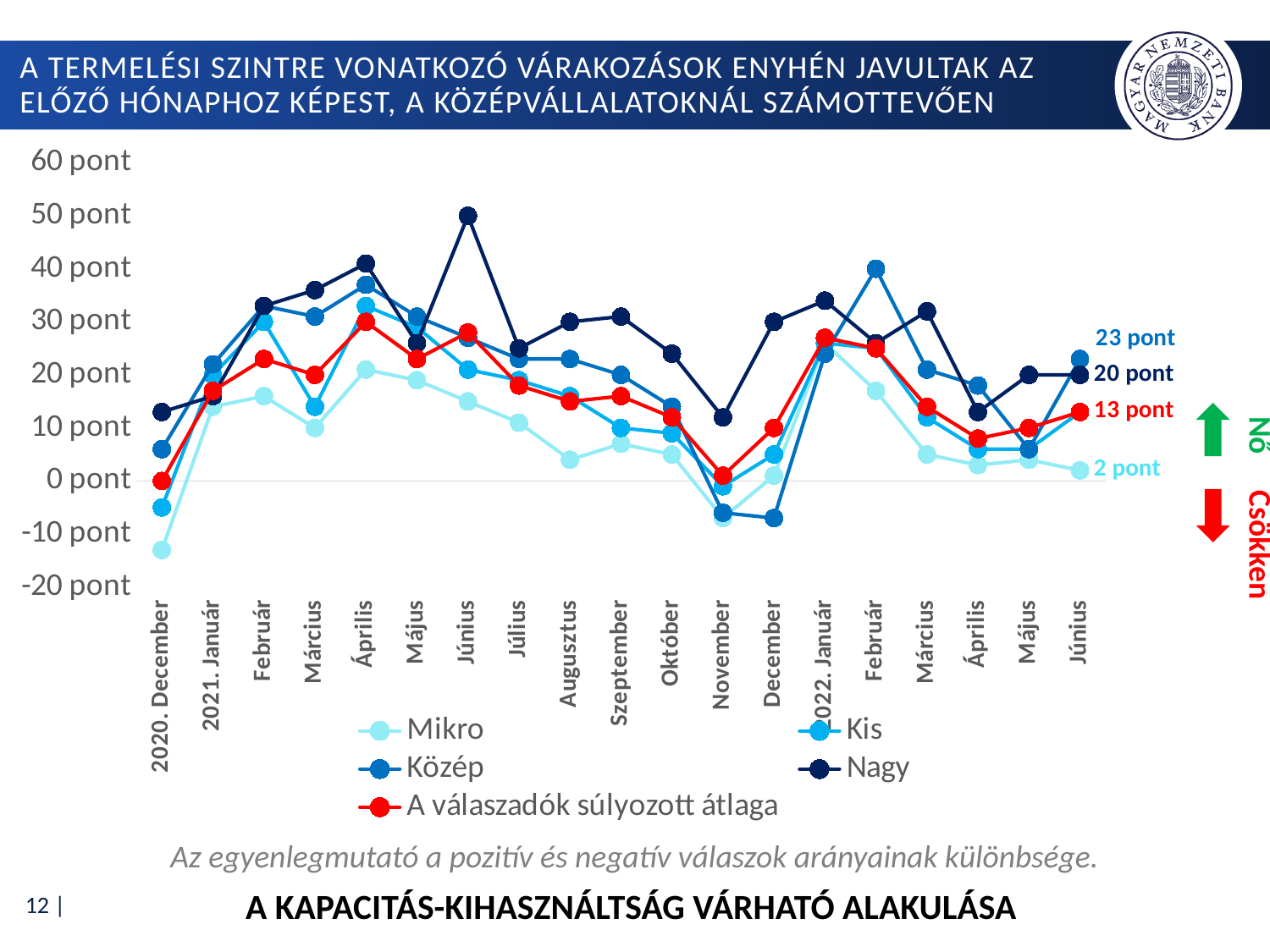
What is the difference between the Közép and Nagy values in 2022 Június? 3 pont What is the value of the Nagy series in 2022 Június? 20 pont How many series does the legend list? 5 Does the Mikro series rise or fall from 2022 Február to 2022 Június? fall Which series has the highest value in 2022 Június? Közép Is the value for Nagy in 2021 Június greater or less than 40 pont? greater How many months are plotted along the x axis? 19 In which month does the Nagy series reach its highest value? 2021 Június What is the value of the Közép series in 2022 Június? 23 pont What kind of chart is shown on the slide? line chart What is the value of the Mikro series in 2022 Június? 2 pont What is the value of 'A válaszadók súlyozott átlaga' in 2022 Június? 13 pont